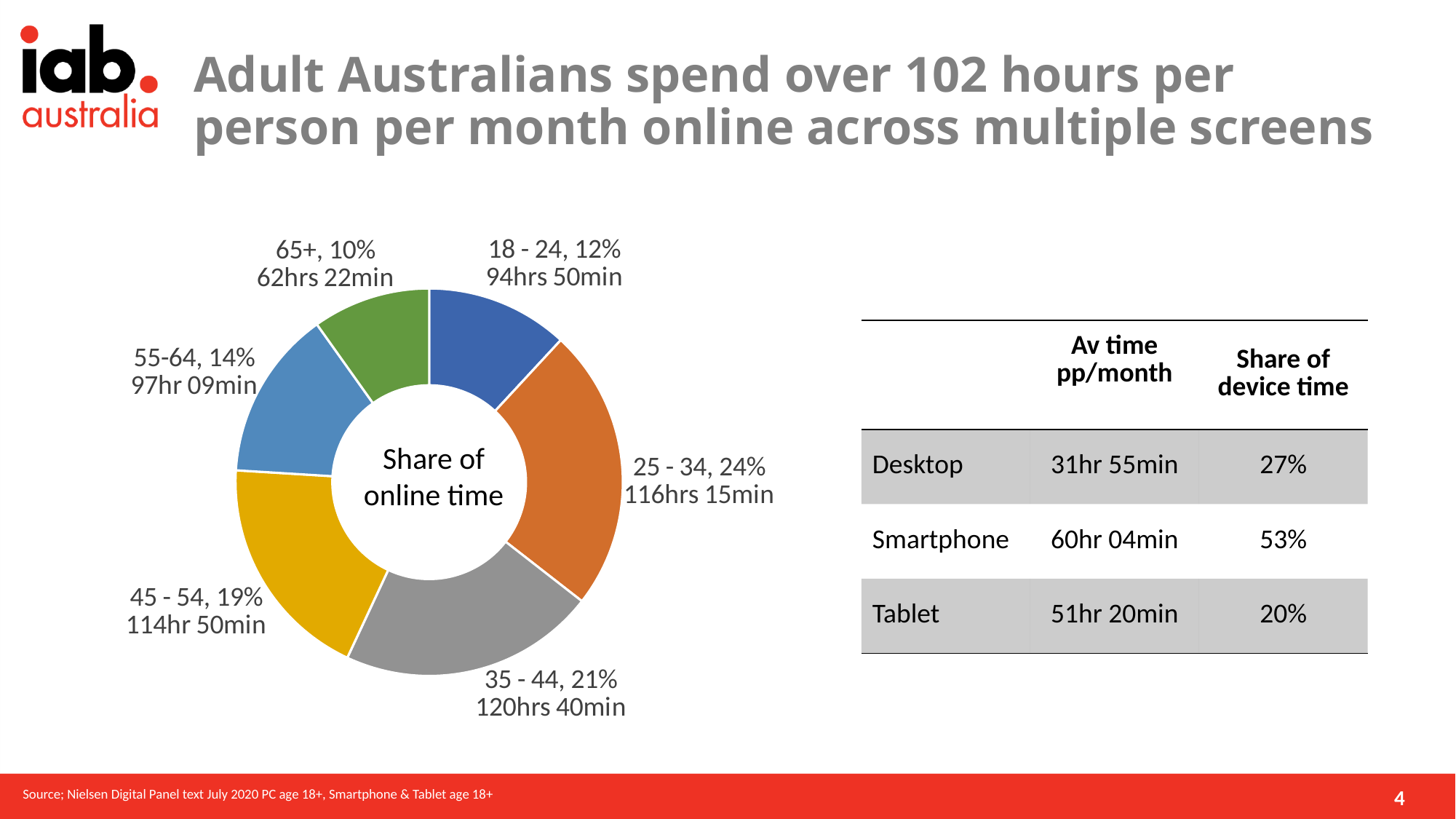
How many hours per month does the 55-64 age group spend online, according to the chart label? 97hr 09min What share of online time does the 65+ age group account for? 10% What text appears in the centre of the doughnut chart? Share of online time Which has a larger share of online time, the 45 - 54 group or the 55-64 group? 45 - 54 What is the difference in share of online time between the 35 - 44 and 18 - 24 age groups? 9 percentage points How many hours per month does the 35 - 44 age group spend online, according to the chart label? 120hrs 40min What share of online time does the 25 - 34 age group account for? 24% Which age group has the largest share of online time? 25 - 34 How many age-group segments does the doughnut chart have? 6 Which age group has the smallest share of online time? 65+ What is the difference in share of online time between the 25 - 34 and 65+ age groups? 14 percentage points What kind of chart is shown on the slide? doughnut (pie) chart